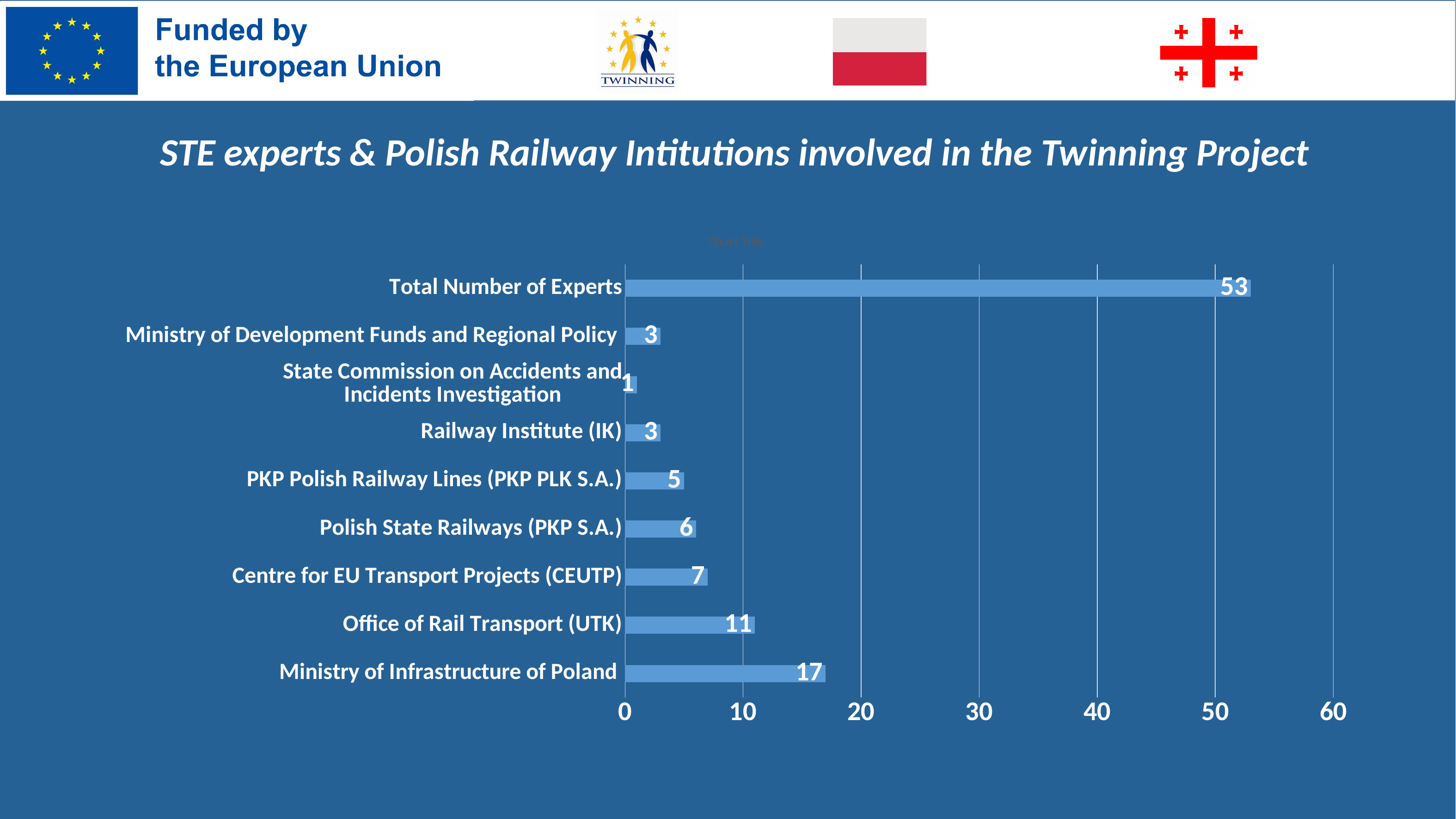
What is the value for Centre for EU Transport Projects (CEUTP)? 7 What is the difference between the values for Ministry of Infrastructure of Poland and Office of Rail Transport (UTK)? 6 Excluding the Total Number of Experts bar, which institution has the highest value? Ministry of Infrastructure of Poland What is the value for State Commission on Accidents and Incidents Investigation? 1 What is the value for Total Number of Experts? 53 Which category has the lowest value? State Commission on Accidents and Incidents Investigation Which is larger, the value for Polish State Railways (PKP S.A.) or PKP Polish Railway Lines (PKP PLK S.A.)? Polish State Railways (PKP S.A.) How many categories are shown on the chart? 9 Is the value for Total Number of Experts greater or less than 50? greater What kind of chart is shown on the slide? bar chart What is the value for Office of Rail Transport (UTK)? 11 What is the value for Ministry of Infrastructure of Poland? 17